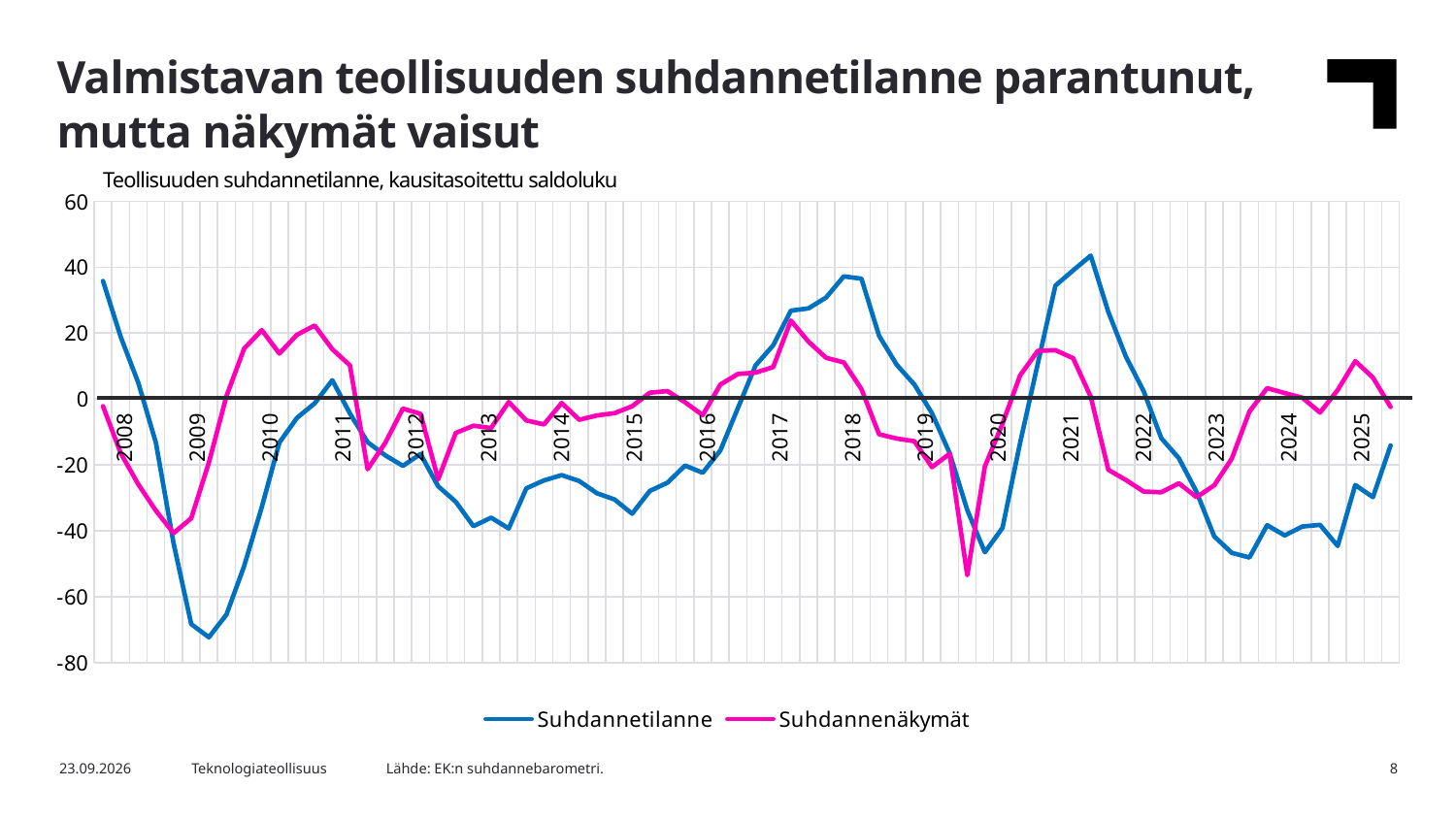
Does the Suhdannetilanne series rise or fall between 2008 and 2009? fall In which year does the Suhdannetilanne series reach its highest value? 2022 What are the two series named in the legend? Suhdannetilanne and Suhdannenäkymät Is the Suhdannenäkymät value at the start of 2008 greater or less than 20? less What kind of chart is shown on the slide? line chart How many series does the legend list? 2 In which year does the Suhdannetilanne series reach its lowest value? 2009 Which series has the higher value at the start of 2008, Suhdannetilanne or Suhdannenäkymät? Suhdannetilanne What is the title printed above the chart? Teollisuuden suhdannetilanne, kausitasoitettu saldoluku Is the lowest value of the Suhdannetilanne series greater or less than -60? less Is the lowest value of the Suhdannenäkymät series, around 2020, greater or less than -40? less